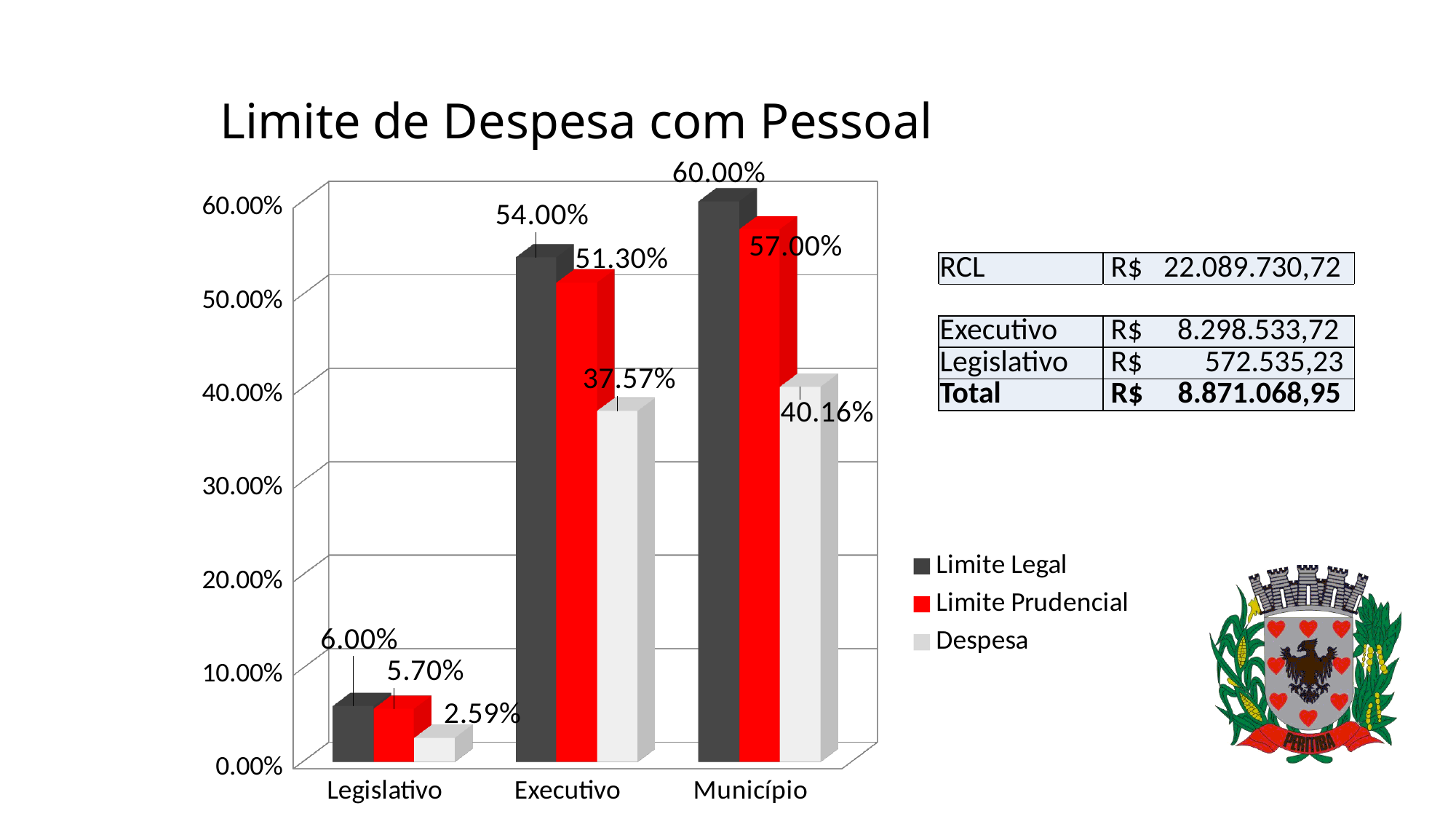
What is the Limite Prudencial value for Legislativo? 5.70% Which category has the highest Limite Legal value? Município How many series does the legend list? 3 How many categories are shown on the x axis? 3 What kind of chart is shown on the slide? Bar chart Which is larger for Legislativo: the Limite Legal or the Despesa? Limite Legal Which category has the lowest Despesa value? Legislativo What is the Despesa value for Executivo? 37.57% What is the Limite Legal value for Executivo? 54.00% What is the difference between the Limite Prudencial and the Despesa for Município? 16.84% What is the difference between the Limite Legal and the Despesa for Executivo? 16.43% What is the Despesa value for Município? 40.16%